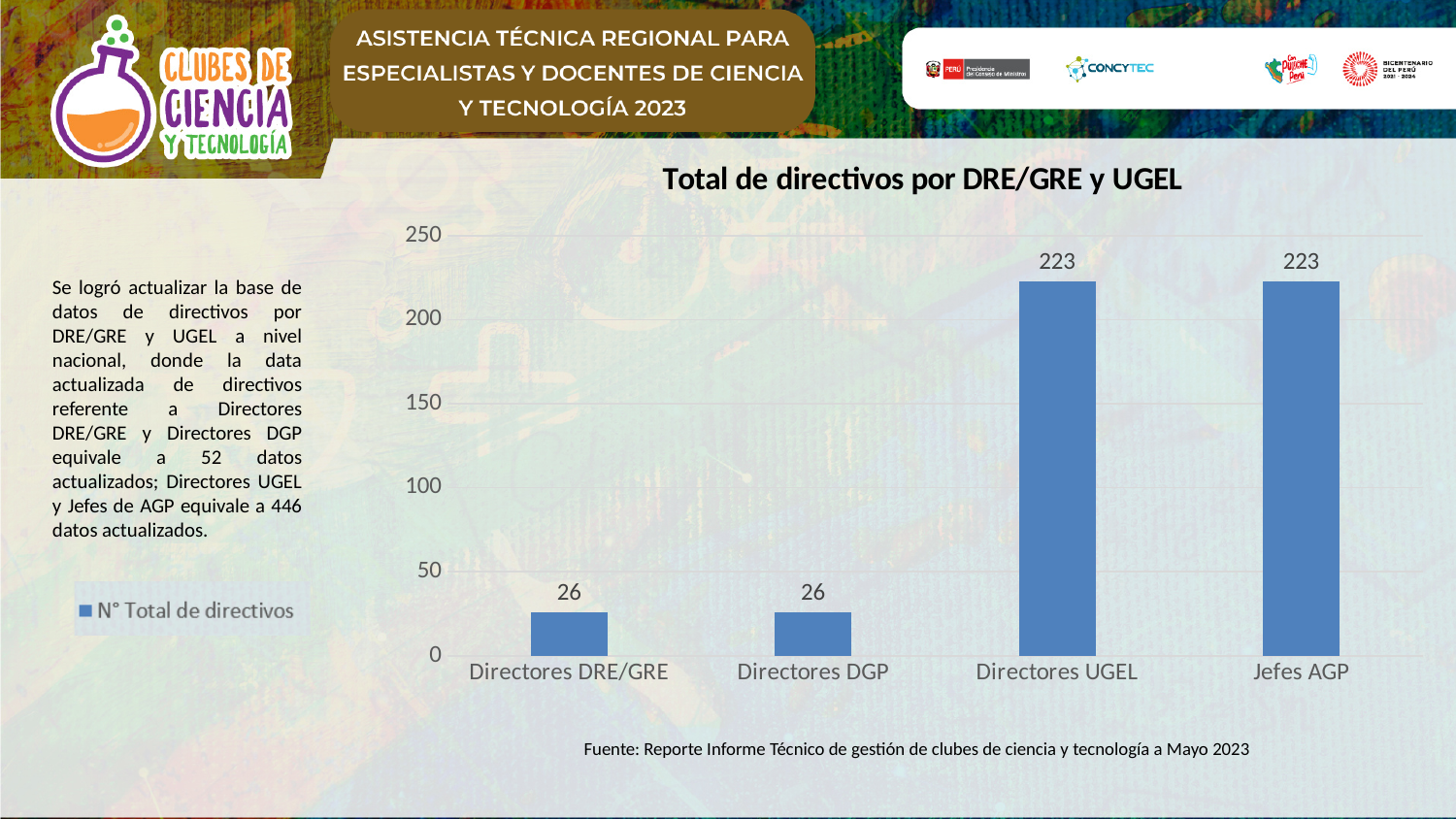
What is the title of the chart? Total de directivos por DRE/GRE y UGEL Which is larger, the value for Jefes AGP or the value for Directores DRE/GRE? Jefes AGP What is the value for Directores DRE/GRE? 26 Is the value for Directores UGEL greater or less than 200? greater What is the value for Jefes AGP? 223 What is the difference between the values for Directores UGEL and Directores DGP? 197 How many series does the legend list? 1 What is the value for Directores DGP? 26 What kind of chart is shown? bar chart What is the value for Directores UGEL? 223 Is the value for Directores DGP greater or less than 50? less How many categories are shown on the x axis? 4